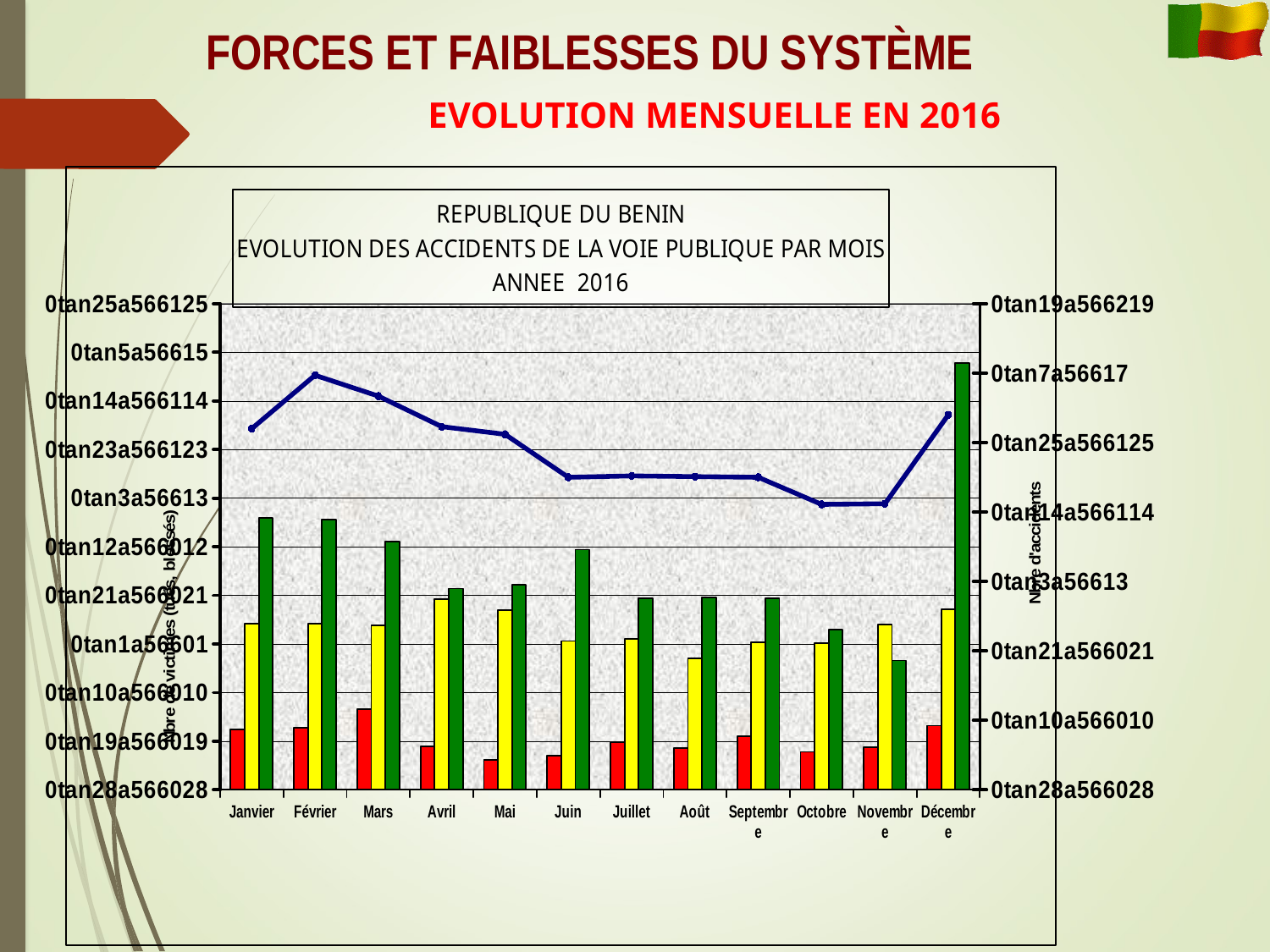
Does the blue line rise or fall from Février to Octobre? Fall Which is larger, the green bar for Janvier or the green bar for Novembre? Janvier What kind of chart is shown on the slide? A bar chart combined with a line In which month is the green bar the highest? Décembre How many bars are plotted for each month? 3 In which month is the red bar the highest? Mars Which is larger, the green bar for Décembre or the green bar for Juin? Décembre In which month is the red bar the lowest? Mai In which month is the yellow bar the lowest? Août What is the title of the chart? REPUBLIQUE DU BENIN EVOLUTION DES ACCIDENTS DE LA VOIE PUBLIQUE PAR MOIS ANNEE 2016 How many months (categories) are shown on the x axis of the chart? 12 In which month does the blue line reach its highest point? Février